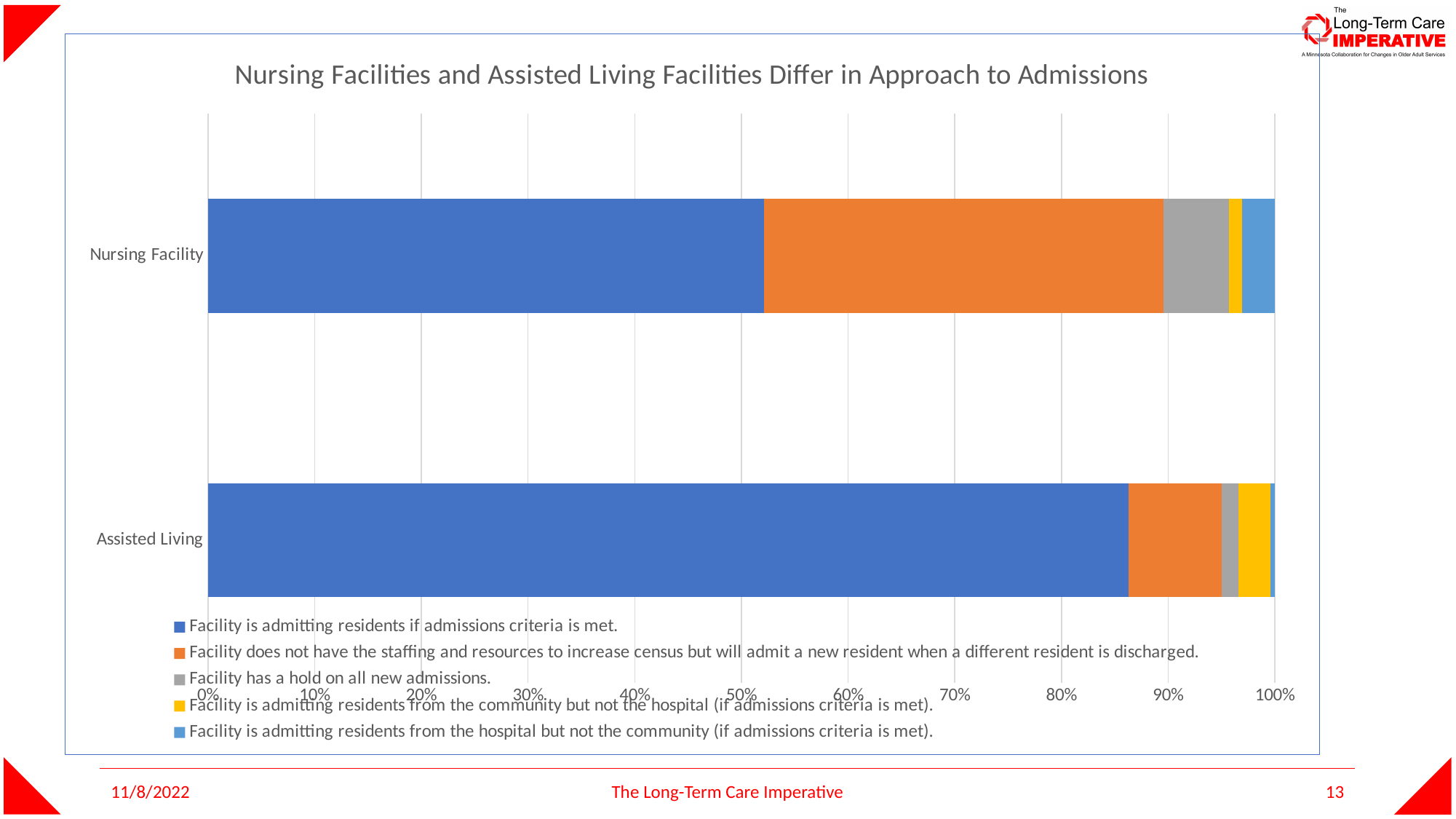
Which facility type has the larger share of respondents that do not have the staffing and resources to increase census but will admit a new resident when a different resident is discharged? Nursing Facility What kind of chart is shown on the slide? Stacked bar chart Is the share of Nursing Facility respondents who are admitting residents if admissions criteria is met greater or less than 40%? greater Which facility type has the larger share of respondents admitting residents if admissions criteria is met, Nursing Facility or Assisted Living? Assisted Living For the Nursing Facility bar, which response category makes up the largest segment? Facility is admitting residents if admissions criteria is met. Which colour represents "Facility has a hold on all new admissions." in the chart? Gray Which facility type has the larger share of respondents admitting residents from the hospital but not the community? Nursing Facility Is the share of Assisted Living respondents who are admitting residents if admissions criteria is met greater or less than 80%? greater What is the title of the chart? Nursing Facilities and Assisted Living Facilities Differ in Approach to Admissions How many facility types (categories) are plotted in the chart? 2 How many series does the legend list? 5